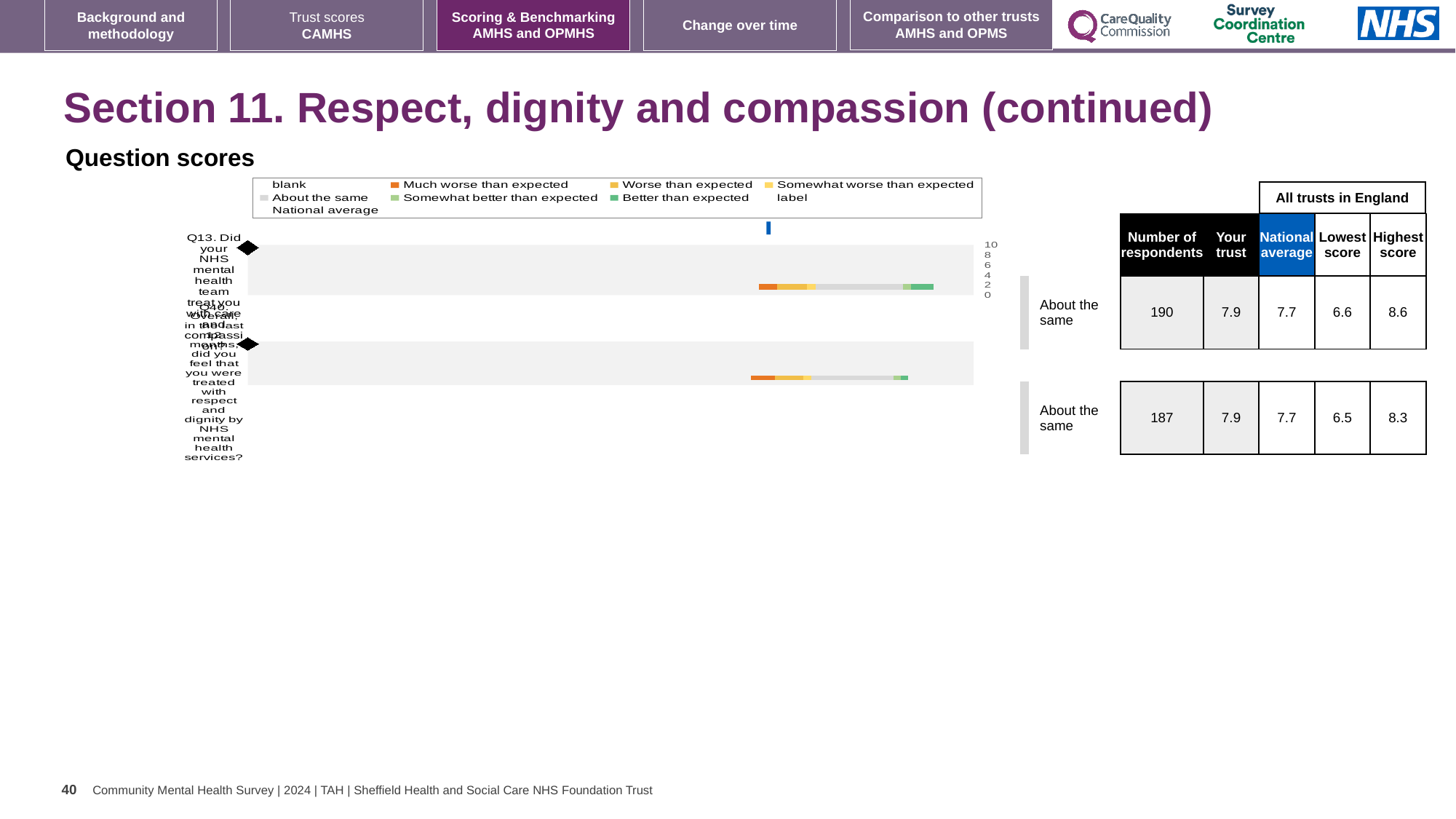
What is the difference between the highest score and the lowest score for Q13 (the top row)? 2.0 How many respondents are listed for Q10 (the bottom row) in the table beside the chart? 187 Which row has the higher 'Highest score' value, Q13 (top) or Q10 (bottom)? Q13 (top) How many respondents are listed for Q13 (the top row) in the table beside the chart? 190 What is the 'Your trust' score for Q13 (the top row)? 7.9 How many questions (bars) are plotted in the Question scores chart? 2 What benchmark category is shown for Q13 (the top bar) in the Question scores chart? About the same What is the lowest score across all trusts in England for Q10 (the bottom row)? 6.5 What kind of chart is shown under 'Question scores'? bar chart What benchmark category is shown for Q10 (the bottom bar) in the Question scores chart? About the same What is the highest score across all trusts in England for Q13 (the top row)? 8.6 What is the national average score for Q10 (the bottom row)? 7.7